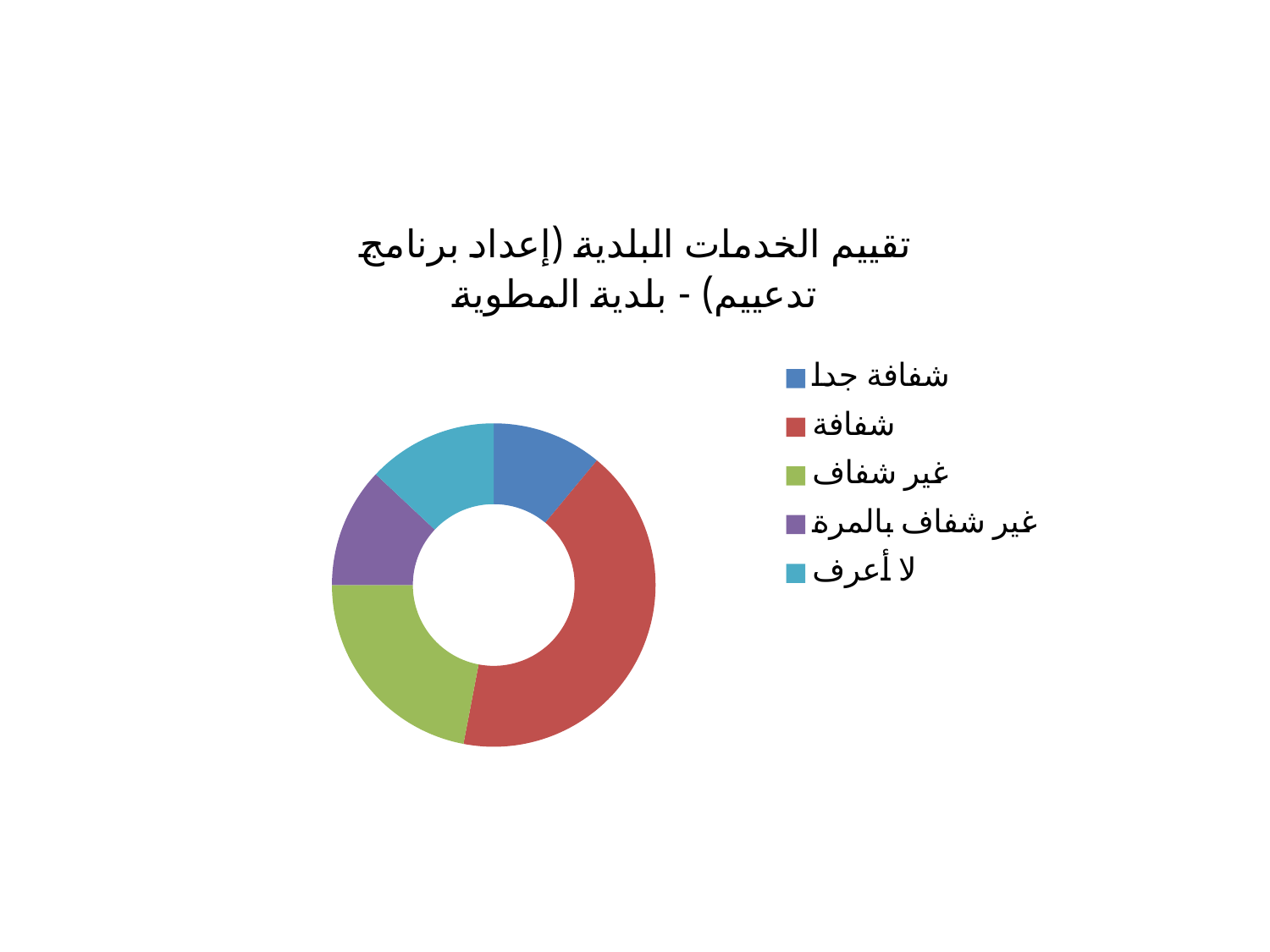
Which is larger, the share for غير شفاف or the share for شفافة جدا? غير شفاف Which is larger, the share for شفافة or the share for غير شفاف? شفافة What kind of chart is shown on the slide? Doughnut chart Which is larger, the share for شفافة or the share for غير شفاف بالمرة? شفافة Which category has the largest share of the doughnut chart? شفافة What is the title of the chart? تقييم الخدمات البلدية (إعداد برنامج تدعييم) - بلدية المطوية How many categories does the legend of the chart list? 5 Which colour represents the category لا أعرف in the chart? Teal (light blue)